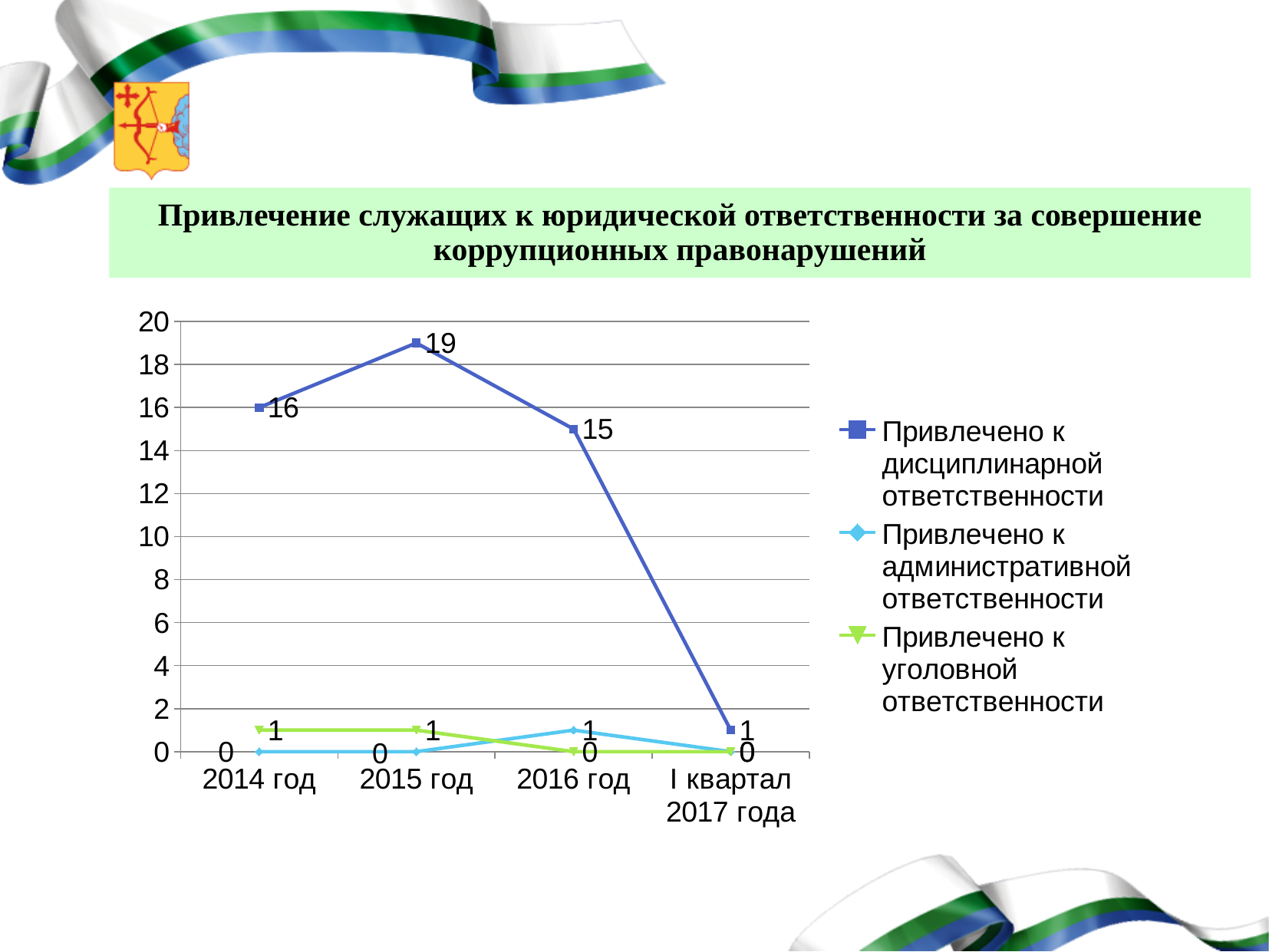
What is the value for 'Привлечено к дисциплинарной ответственности' in 2016 год? 15 How many categories are shown on the x axis? 4 In which category is the value for 'Привлечено к дисциплинарной ответственности' lowest? I квартал 2017 года What is the value for 'Привлечено к административной ответственности' in 2016 год? 1 What is the value for 'Привлечено к дисциплинарной ответственности' in I квартал 2017 года? 1 How many series does the legend list? 3 What kind of chart is shown on the slide? line chart What is the difference between the 'Привлечено к дисциплинарной ответственности' values for 2015 год and 2016 год? 4 In which category is the value for 'Привлечено к дисциплинарной ответственности' highest? 2015 год Which is larger for 'Привлечено к дисциплинарной ответственности': the value for 2014 год or for 2016 год? 2014 год Does the 'Привлечено к дисциплинарной ответственности' series rise or fall from 2015 год to I квартал 2017 года? fall What is the value for 'Привлечено к дисциплинарной ответственности' in 2015 год? 19